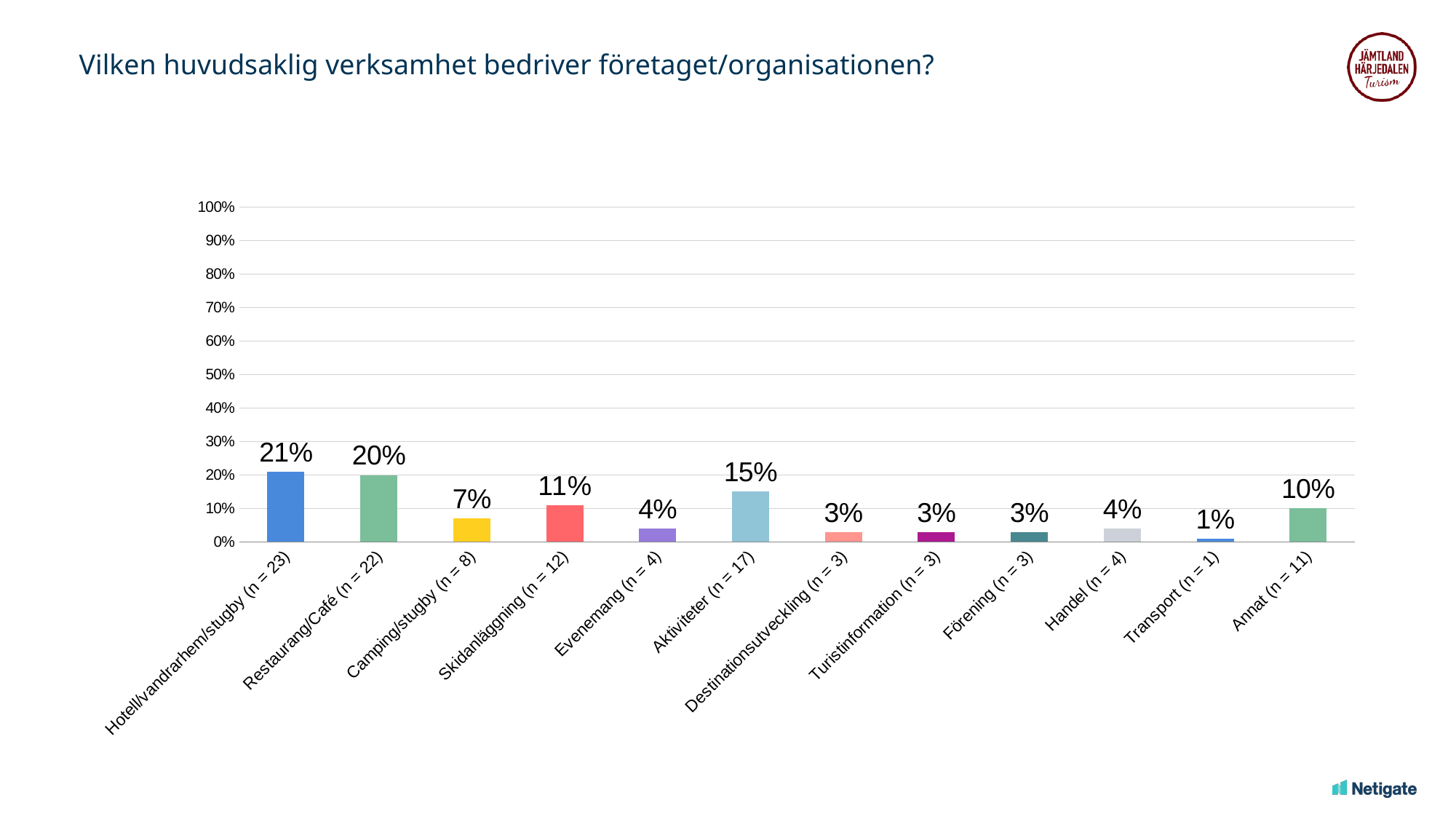
How many categories are shown on the x axis? 12 Which category has the highest value? Hotell/vandrarhem/stugby (n = 23) What kind of chart is shown on the slide? bar chart Which is larger, the value for Restaurang/Café (n = 22) or the value for Aktiviteter (n = 17)? Restaurang/Café (n = 22) What is the highest value shown on the y axis? 100% What is the title of the slide? Vilken huvudsaklig verksamhet bedriver företaget/organisationen? Is the value for Skidanläggning (n = 12) greater or less than 20%? less What is the difference between the values for Hotell/vandrarhem/stugby (n = 23) and Camping/stugby (n = 8)? 14% Which category has the lowest value? Transport (n = 1) What is the value for Skidanläggning (n = 12)? 11% What is the value for Aktiviteter (n = 17)? 15% What is the value for Annat (n = 11)? 10%